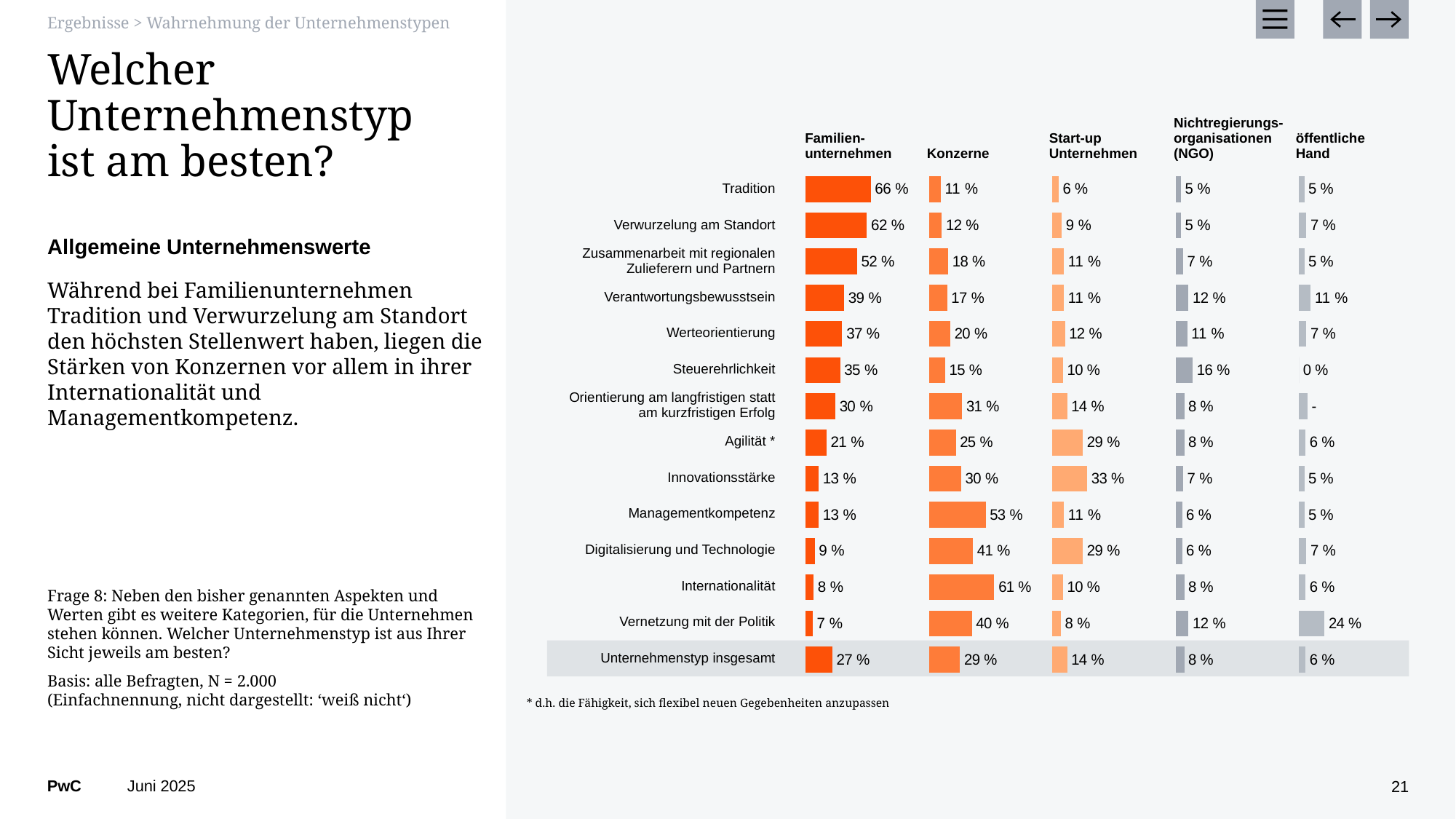
What percentage of respondents chose Familienunternehmen as best for Tradition? 66 % Which category has the highest value for Nichtregierungsorganisationen (NGO)? Steuerehrlichkeit What is the value for Konzerne in the row Unternehmenstyp insgesamt? 29 % Which category has the lowest value for Familienunternehmen? Vernetzung mit der Politik What is the difference between the Familienunternehmen and Konzerne values for Managementkompetenz? 40 % What is the value for Konzerne in the Internationalität row? 61 % Which category has the highest value for Familienunternehmen? Tradition How many company types (series) are shown in the chart? 5 For Digitalisierung und Technologie, which is larger: the value for Konzerne or for Start-up Unternehmen? Konzerne What is the value for öffentliche Hand for Vernetzung mit der Politik? 24 % What type of chart is shown on the slide? Bar chart What is the value for Start-up Unternehmen for Innovationsstärke? 33 %